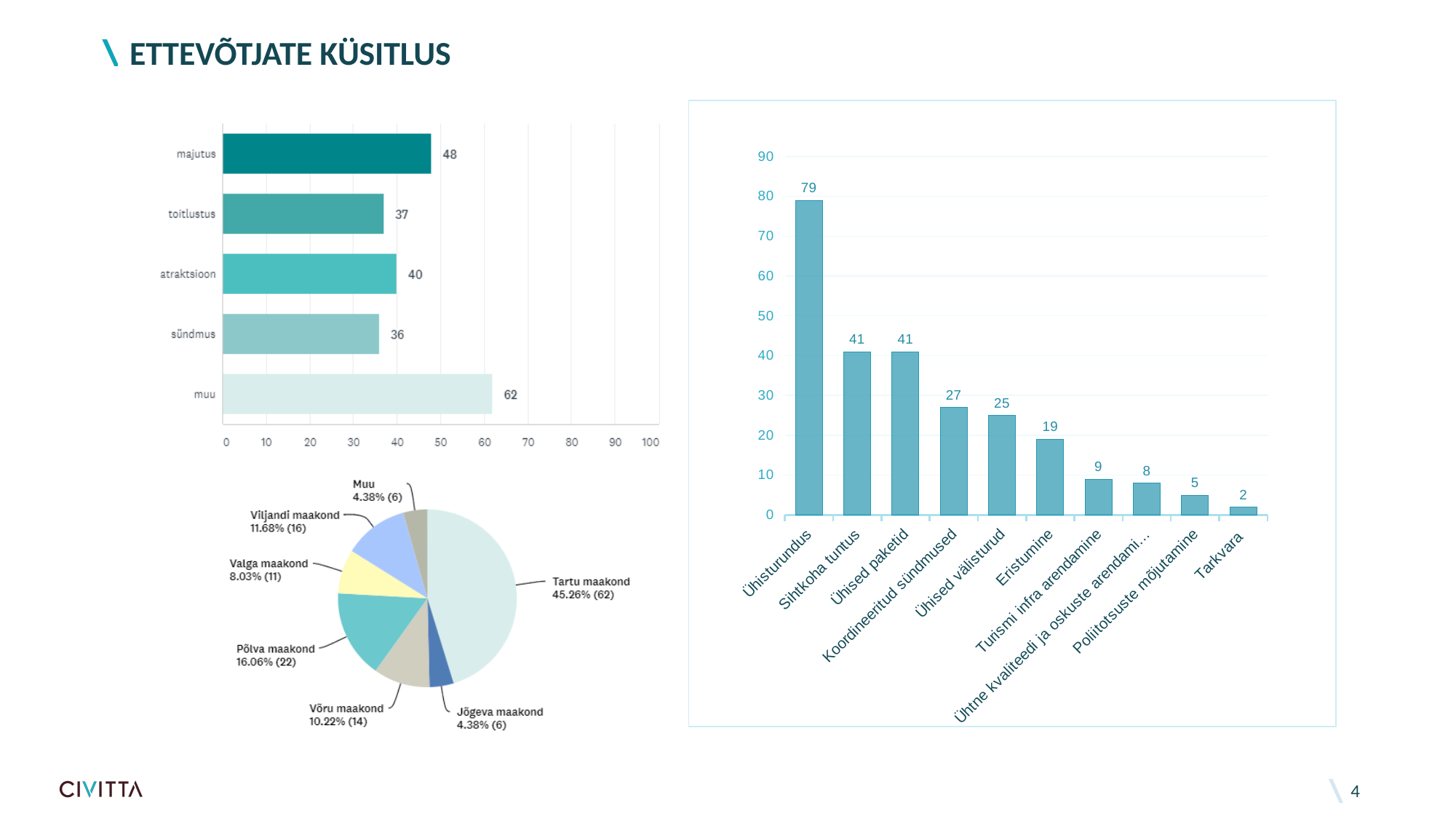
In the right-hand bar chart, do the values rise or fall from left to right along the x axis? fall In the top-left bar chart, what is the difference between the values for muu and toitlustus? 25 In the top-left bar chart, what is the value for majutus? 48 In the bottom-left pie chart, what is the count shown for Põlva maakond? 22 In the top-left bar chart, which category has the highest value? muu In the bottom-left pie chart, what share does Tartu maakond have? 45.26% In the right-hand bar chart, which category has the lowest value? Tarkvara In the bottom-left pie chart, which is larger, Viljandi maakond or Võru maakond? Viljandi maakond In the right-hand bar chart, what is the value for Ühisturundus? 79 In the right-hand bar chart, what is the difference between Ühisturundus and Sihtkoha tuntus? 38 In the top-left bar chart, which category has the lowest value? sündmus In the top-left bar chart, how many categories are shown? 5